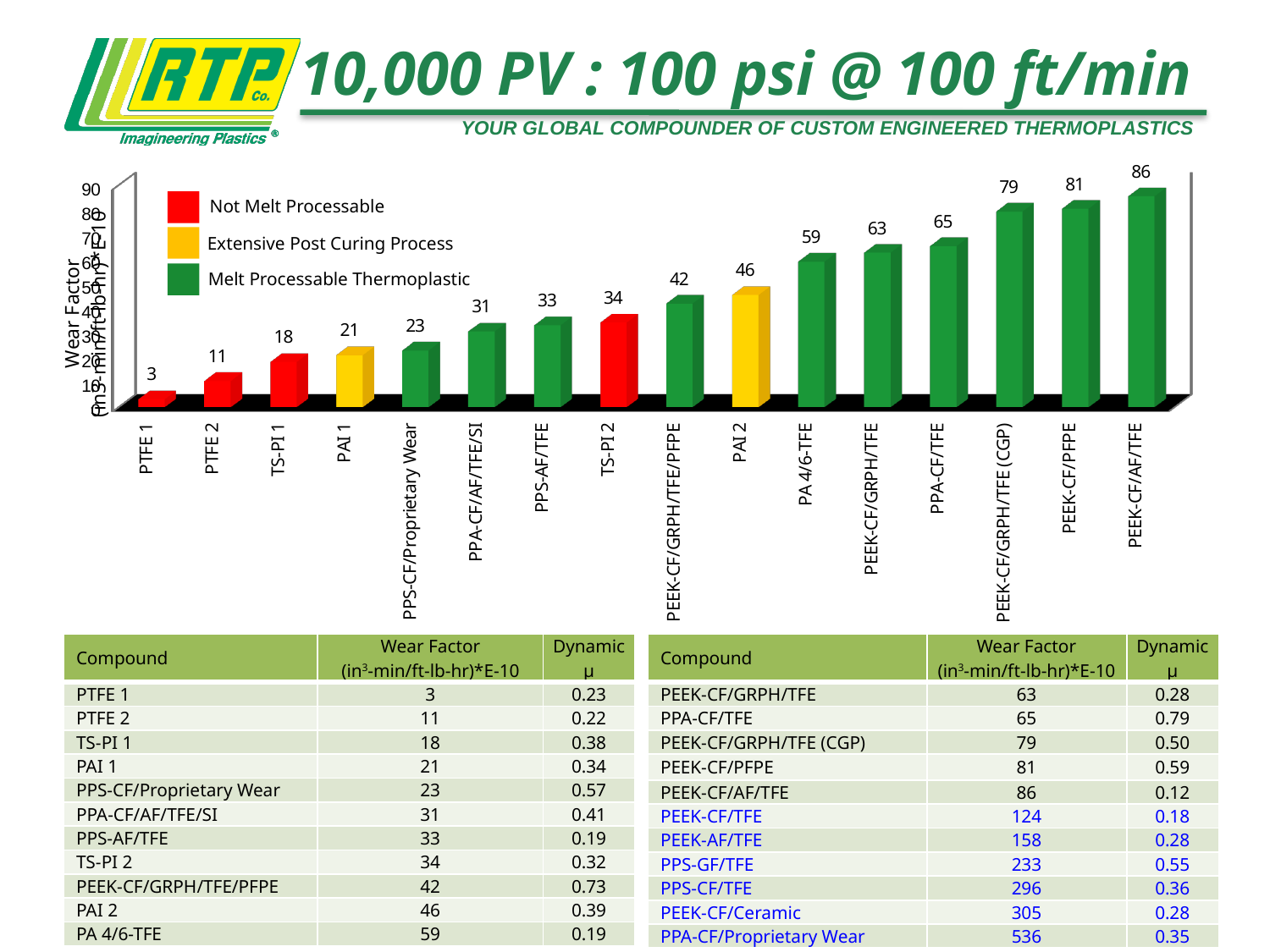
What is the wear factor value shown for PPS-AF/TFE in the chart? 33 Which has a higher wear factor in the chart, TS-PI 2 or PPA-CF/TFE? PPA-CF/TFE According to the chart legend, what does a red bar indicate? Not Melt Processable What type of chart is shown on the slide? Bar chart How many entries does the chart legend list? 3 Which compound has the lowest wear factor in the chart? PTFE 1 Do the wear factor values rise or fall from left to right along the x axis of the chart? Rise What is the wear factor value shown for PAI 2 in the chart? 46 What is the wear factor value shown for PEEK-CF/AF/TFE in the chart? 86 What is the difference between the wear factor of PEEK-CF/PFPE and that of PA 4/6-TFE in the chart? 22 How many bars are plotted in the chart? 16 Which compound has the highest wear factor in the chart? PEEK-CF/AF/TFE